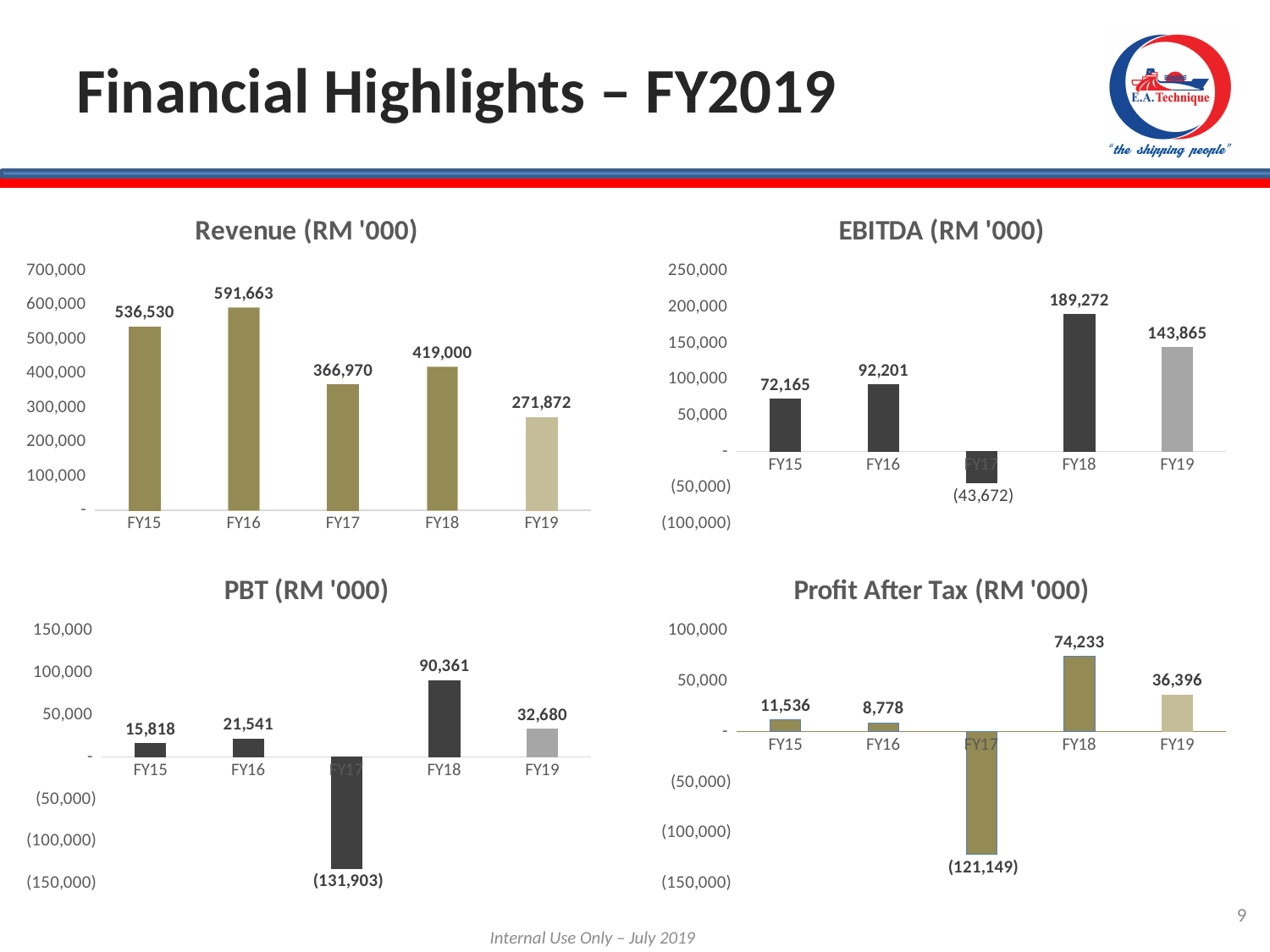
In the Revenue (RM '000) chart, what is the value for FY16? 591,663 In the EBITDA (RM '000) chart, what is the value for FY17? (43,672) How many years are shown in the Profit After Tax (RM '000) chart? 5 In the PBT (RM '000) chart, which is larger, FY15 or FY16? FY16 In the Revenue (RM '000) chart, what is the difference between FY18 and FY17? 52,030 In the EBITDA (RM '000) chart, which year has the highest EBITDA? FY18 In the PBT (RM '000) chart, what is the difference between FY18 and FY19? 57,681 In the PBT (RM '000) chart, what is the value for FY19? 32,680 What type of chart is the Revenue (RM '000) chart? Bar chart In the Profit After Tax (RM '000) chart, what is the value for FY17? (121,149) In the Revenue (RM '000) chart, which year has the lowest revenue? FY19 In the EBITDA (RM '000) chart, is the value for FY19 greater or less than 100,000? greater